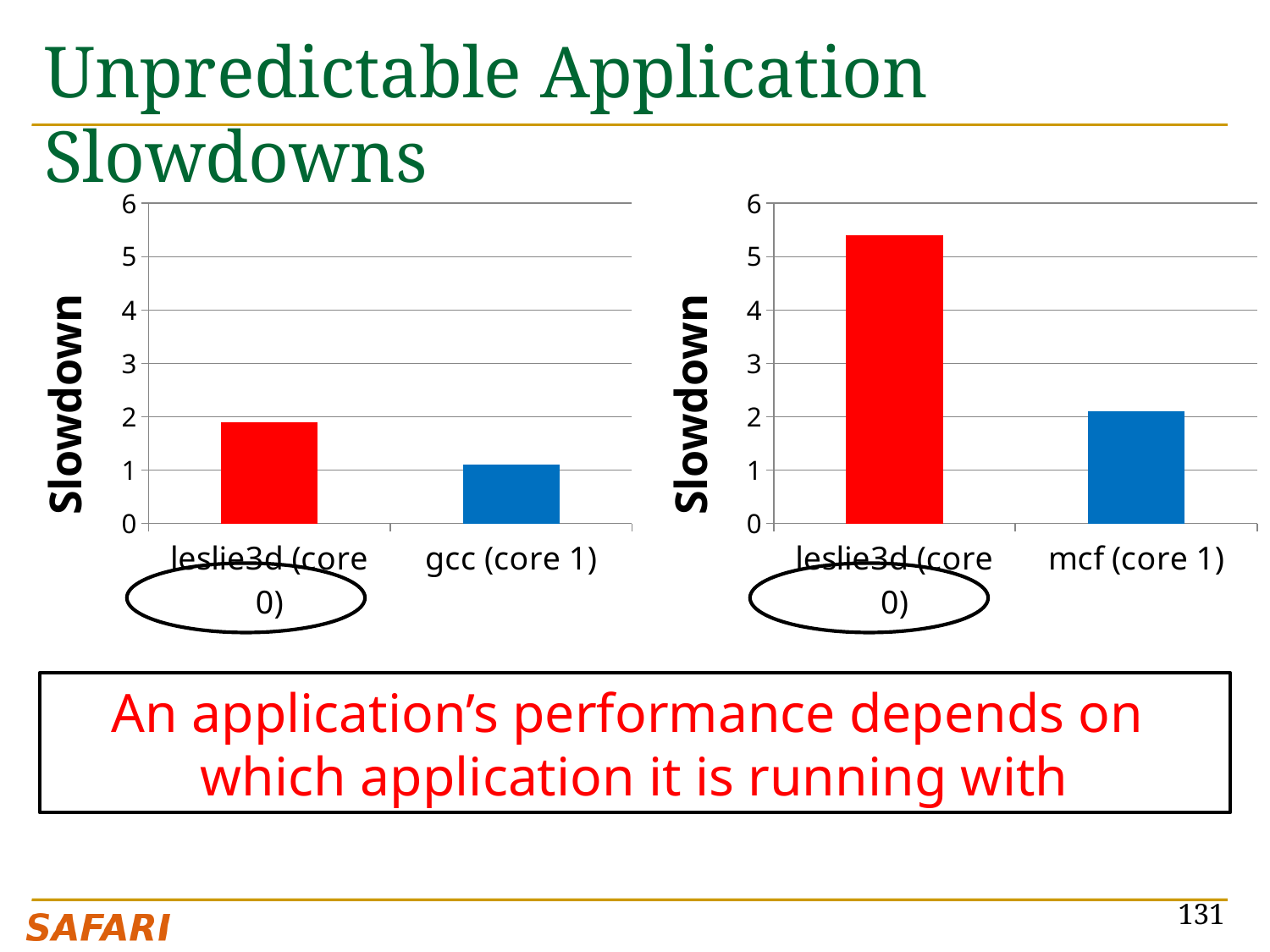
In the right chart, is the slowdown for leslie3d (core 0) greater or less than 5? greater In the right chart, which category has the lowest slowdown? mcf (core 1) In the left chart, is the slowdown for gcc (core 1) greater or less than 2? less What kind of chart is the right chart? bar chart In the right chart, which category has the highest slowdown? leslie3d (core 0) In the left chart, which category has the higher slowdown? leslie3d (core 0) In the left chart, which category has the lower slowdown? gcc (core 1) How many categories are shown in the left chart? 2 In the right chart, is the slowdown for leslie3d (core 0) larger or smaller than the slowdown for mcf (core 1)? larger What is the y-axis label of the left chart? Slowdown